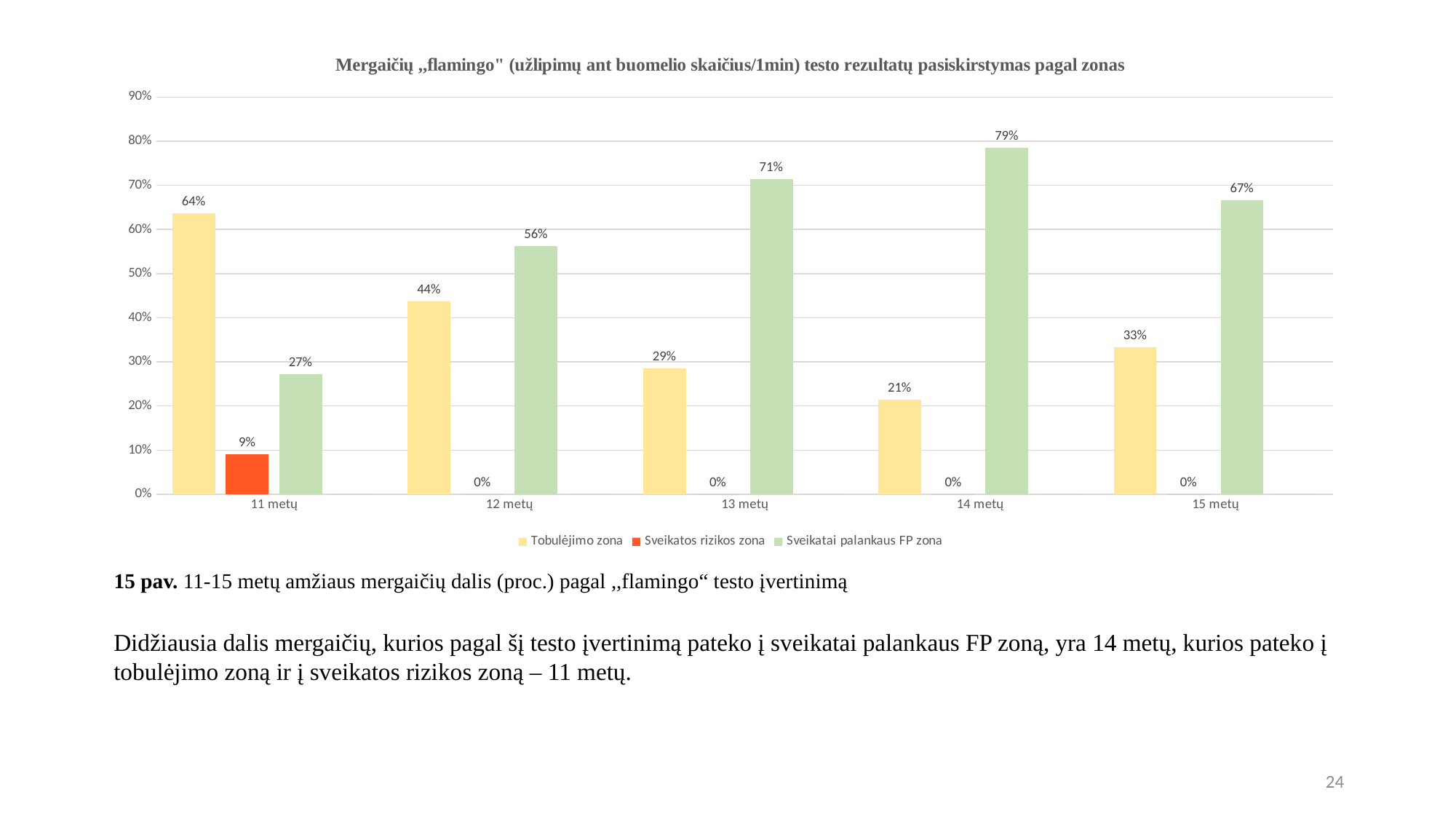
Which series is shown in orange in the legend? Sveikatos rizikos zona What is the value for Tobulėjimo zona at 11 metų? 64% How many age groups are shown on the x axis? 5 Which is larger at 12 metų: Tobulėjimo zona or Sveikatai palankaus FP zona? Sveikatai palankaus FP zona What kind of chart is shown on the slide? Bar chart What is the value for Tobulėjimo zona at 15 metų? 33% What is the difference between Sveikatai palankaus FP zona and Tobulėjimo zona at 13 metų? 42% Which age group has the lowest value for Tobulėjimo zona? 14 metų What is the value for Sveikatos rizikos zona at 11 metų? 9% What is the value for Sveikatai palankaus FP zona at 14 metų? 79% Which age group has the highest value for Sveikatai palankaus FP zona? 14 metų How many series does the legend list? 3